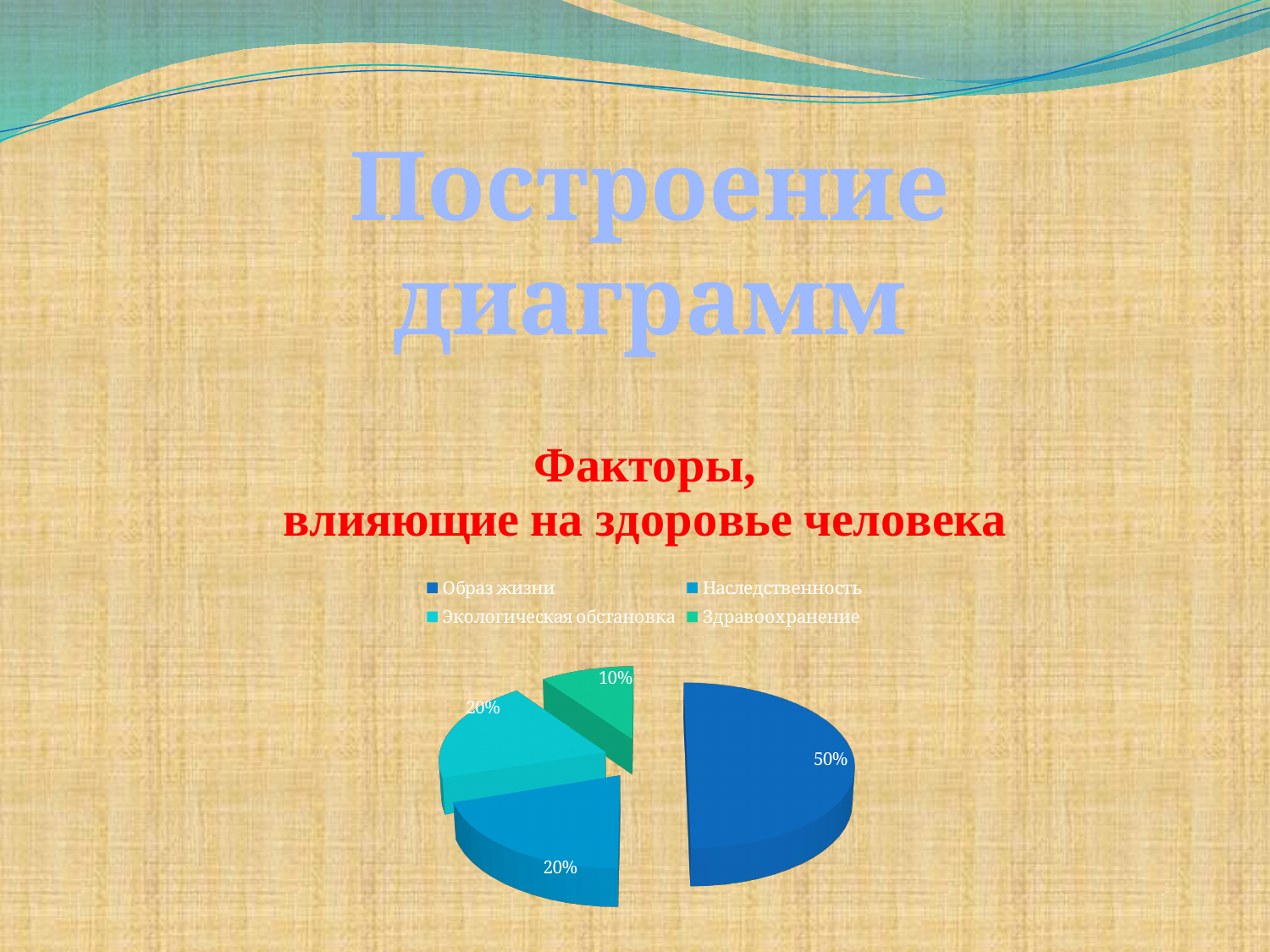
What share of the pie does Наследственность have? 20% What share of the pie does Экологическая обстановка have? 20% Which category has the smallest slice of the pie? Здравоохранение Which category has the largest slice of the pie? Образ жизни Which is larger, the share of Наследственность or the share of Здравоохранение? Наследственность What kind of chart is shown on the slide? pie chart What share of the pie does Здравоохранение have? 10% How many categories does the legend of the pie chart list? 4 Which legend entry is shown in green? Здравоохранение What is the title of the chart? Факторы, влияющие на здоровье человека What is the difference between the shares of Образ жизни and Здравоохранение? 40%